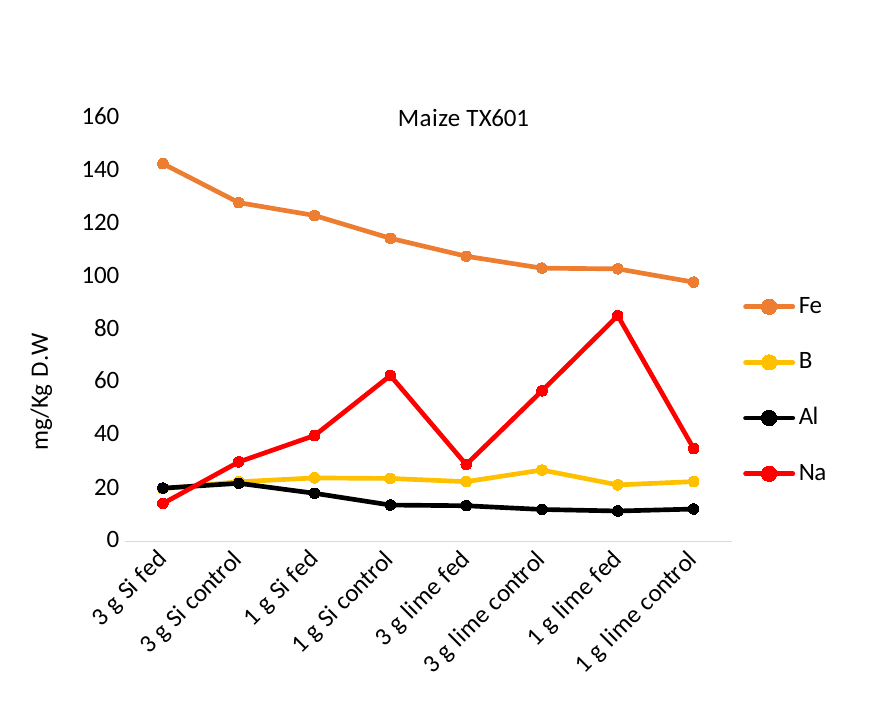
At which category does the Na series reach its highest value? 1 g lime fed Which series has the highest values across all categories? Fe At 1 g lime fed, which is larger, the Na value or the B value? Na What kind of chart is shown on the slide? line chart How many categories are shown along the x axis? 8 Is the Na value for 1 g lime fed greater or less than 80? greater How many series does the legend list? 4 What is the label of the y axis? mg/Kg D.W Does the Fe series rise or fall from left to right across the categories? fall At which category is the Fe value lowest? 1 g lime control What is the title of the chart? Maize TX601